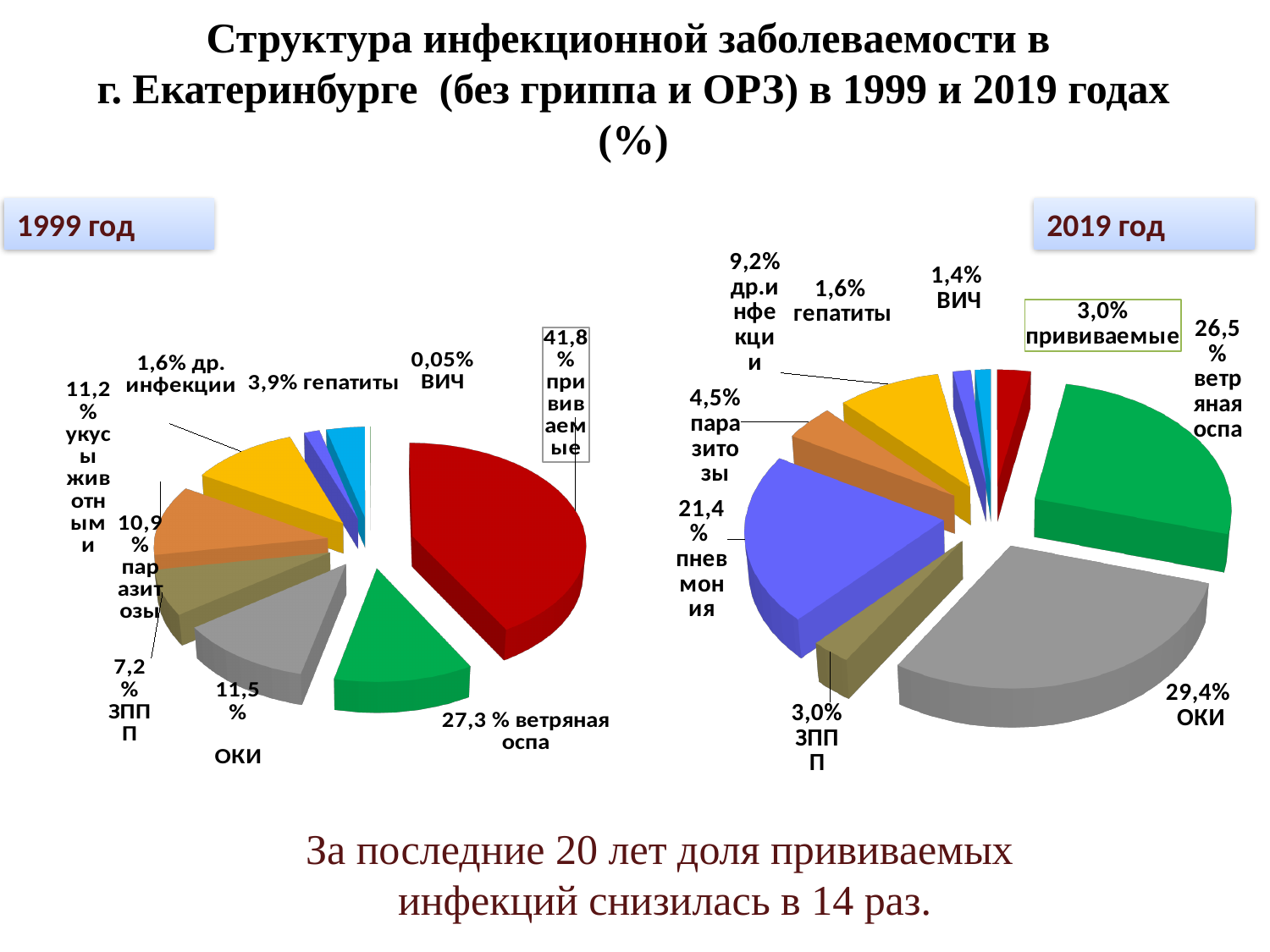
In the 1999 pie chart (left), which category has the largest share? прививаемые In the 2019 pie chart (right), what share is labelled for ОКИ? 29,4% In the 2019 pie chart (right), which is larger: the share of ветряная оспа or the share of пневмония? ветряная оспа In the 1999 pie chart (left), which category has the smallest share? ВИЧ How many slices does the 1999 pie chart (left) have? 9 What is the difference between the share of прививаемые in the 1999 chart and in the 2019 chart? 38,8% In the 2019 pie chart (right), what share is labelled for пневмония? 21,4% In the 1999 pie chart (left), what share is labelled for прививаемые? 41,8% In the 1999 pie chart (left), what share is labelled for ВИЧ? 0,05% What type of chart is used to show the 2019 data (right)? pie chart In the 2019 pie chart (right), which category has the smallest share? ВИЧ In the 2019 pie chart (right), which category has the largest share? ОКИ